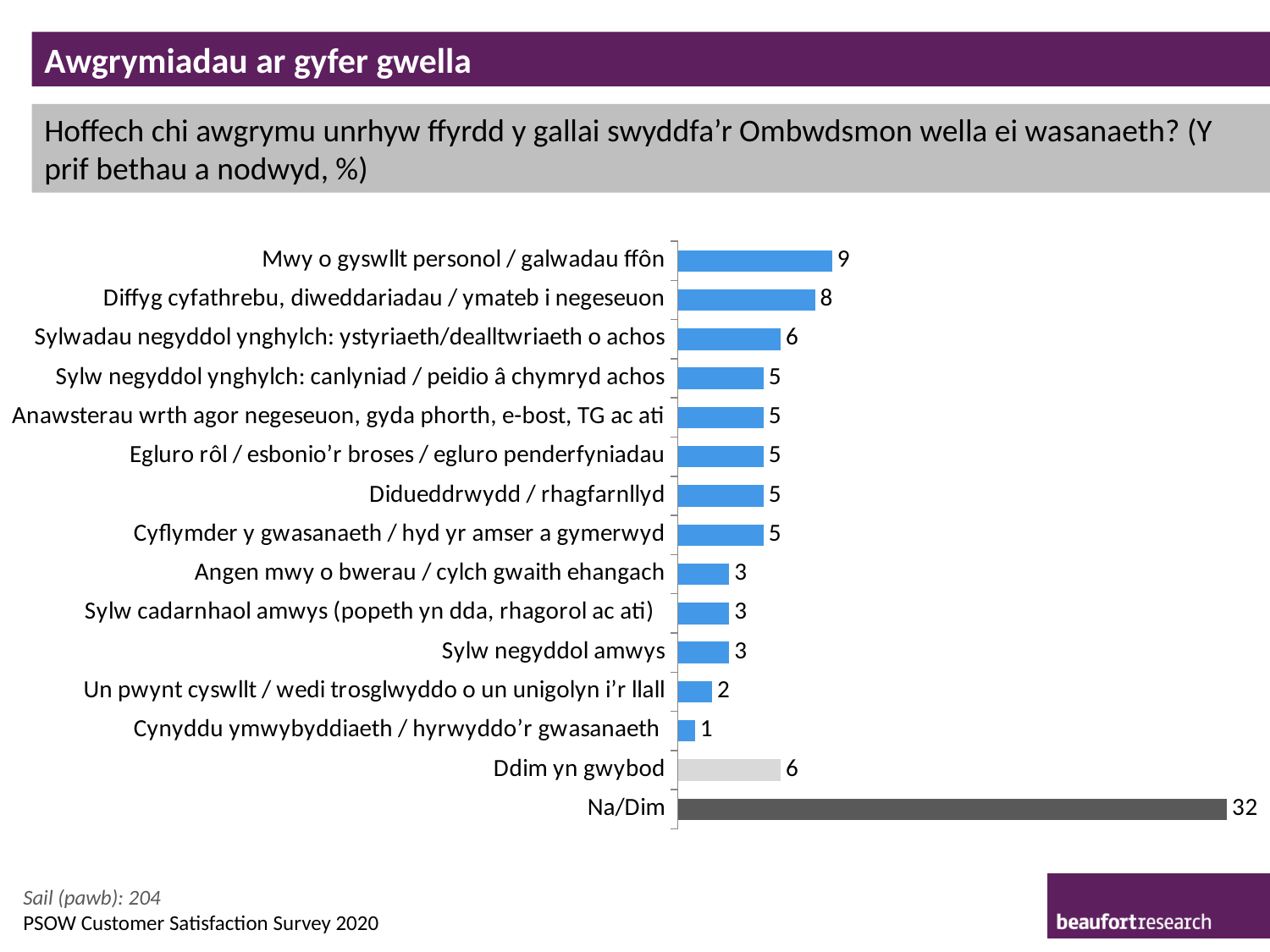
What is the difference between the values for "Na/Dim" and "Mwy o gyswllt personol / galwadau ffôn"? 23 What is the value for "Cynyddu ymwybyddiaeth / hyrwyddo'r gwasanaeth"? 1 What is the value for "Na/Dim"? 32 What kind of chart is shown on the slide? Bar chart What colour is the bar for "Na/Dim"? Dark grey What is the value for "Mwy o gyswllt personol / galwadau ffôn"? 9 What is the difference between the values for "Diffyg cyfathrebu, diweddariadau / ymateb i negeseuon" and "Sylwadau negyddol ynghylch: ystyriaeth/dealltwriaeth o achos"? 2 Which is larger, the value for "Angen mwy o bwerau / cylch gwaith ehangach" or the value for "Un pwynt cyswllt / wedi trosglwyddo o un unigolyn i'r llall"? Angen mwy o bwerau / cylch gwaith ehangach What is the value for "Ddim yn gwybod"? 6 Which category has the highest value? Na/Dim How many categories are shown in the chart? 15 Which category has the lowest value? Cynyddu ymwybyddiaeth / hyrwyddo'r gwasanaeth